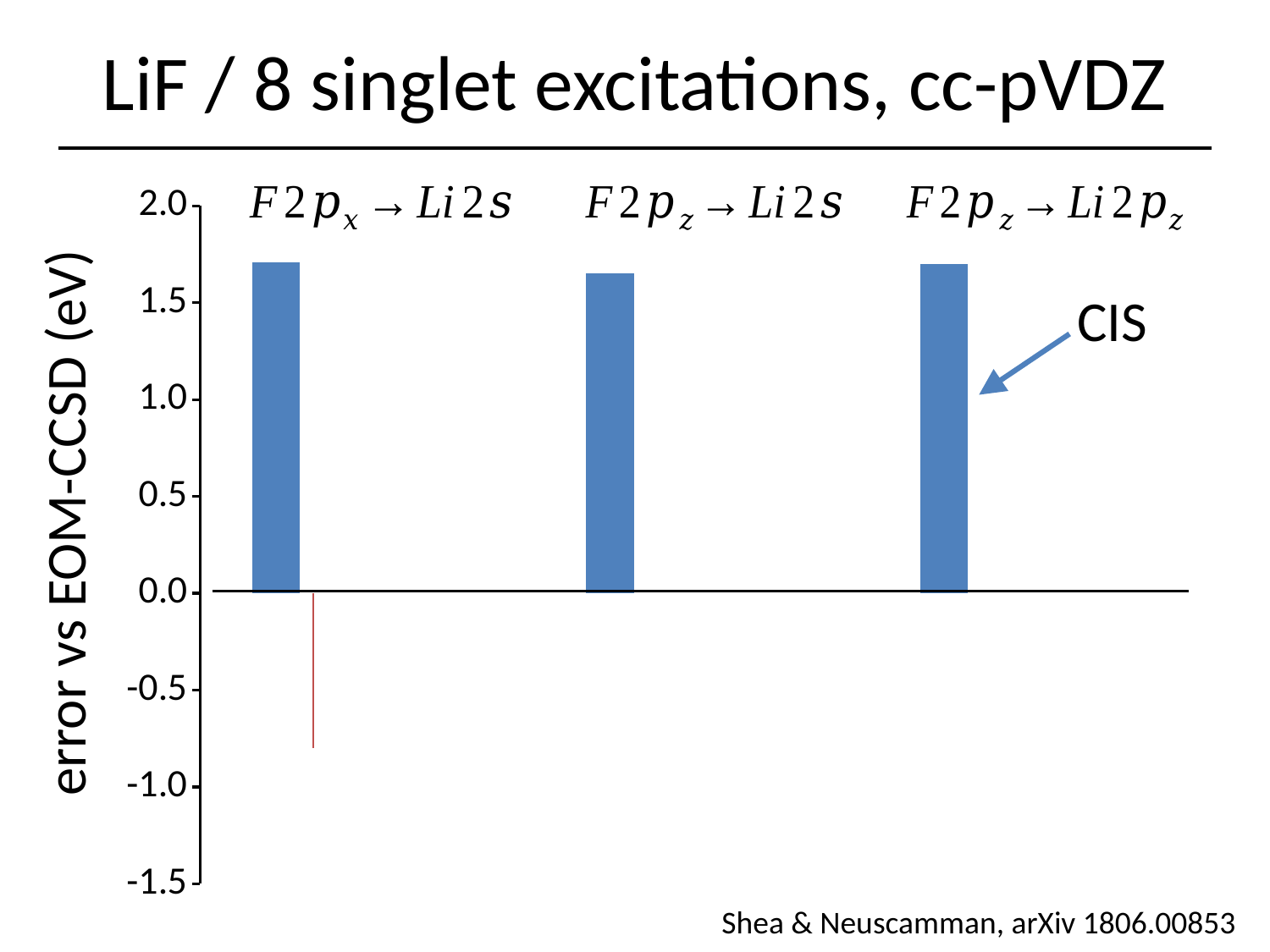
Is the CIS error for F 2pz → Li 2s greater or less than 1.5? greater Is the CIS error for F 2px → Li 2s greater or less than 2.0? less What is the lowest value shown on the vertical axis? -1.5 How many excitation categories are labelled along the top of the chart? 3 Is the CIS error for F 2px → Li 2s greater or less than 1.5? greater What is the title of the slide? LiF / 8 singlet excitations, cc-pVDZ What is the highest value shown on the vertical axis? 2.0 What kind of chart is shown on the slide? bar chart